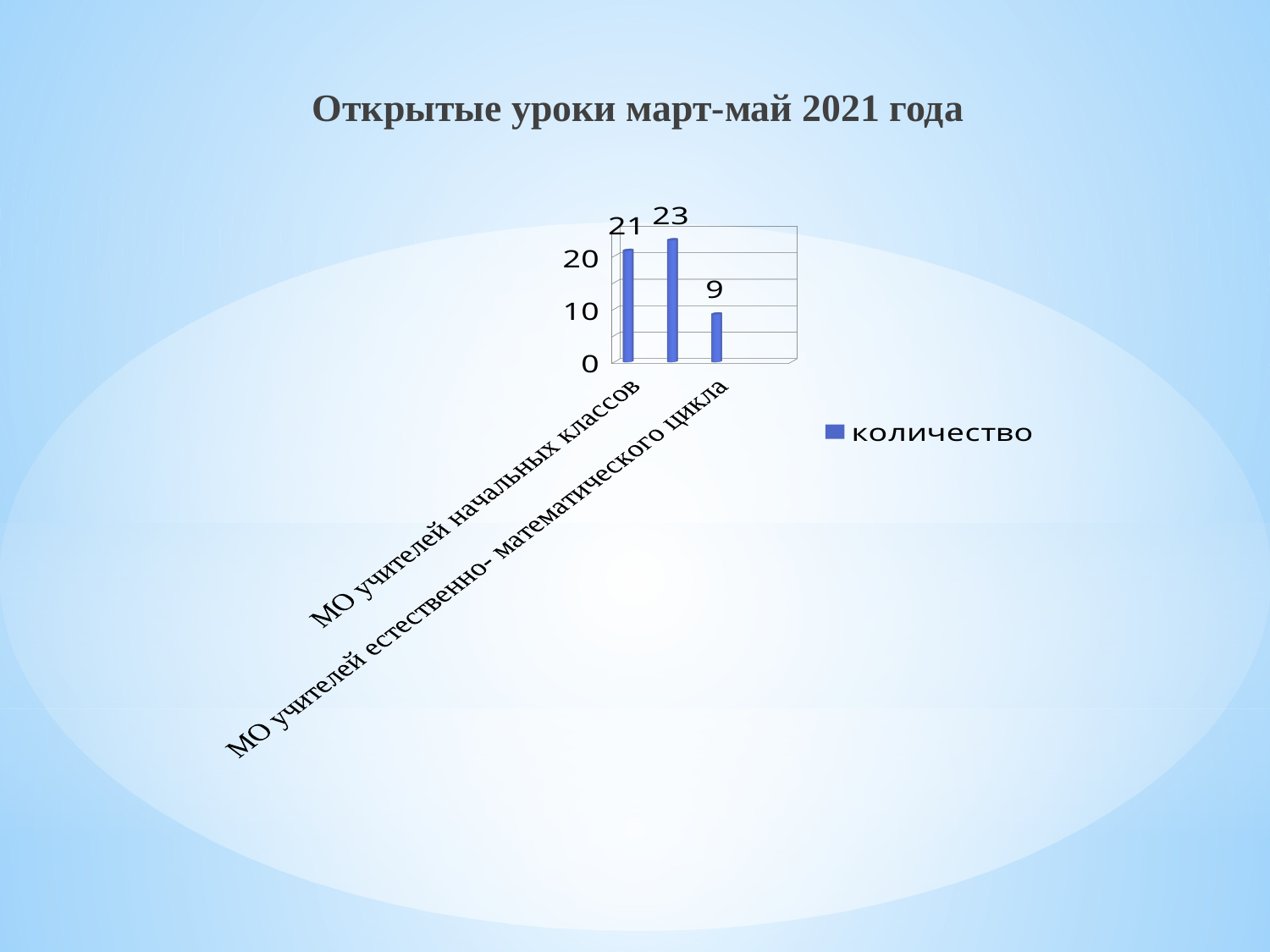
Which is larger: the value for МО учителей начальных классов or for МО учителей естественно- математического цикла? МО учителей начальных классов What is the difference between the values for МО учителей естественно- математического цикла and МО учителей начальных классов? 12 What is the value for МО учителей естественно- математического цикла? 9 What kind of chart is shown on the slide? bar chart How many series does the legend list? 1 What is the difference between the highest bar (23) and the lowest bar (9)? 14 What is the value for МО учителей начальных классов? 21 What is the value of the third (rightmost) bar? 9 What is the legend entry of the chart? количество What is the lowest value shown on the chart? 9 How many bars are plotted on the chart? 3